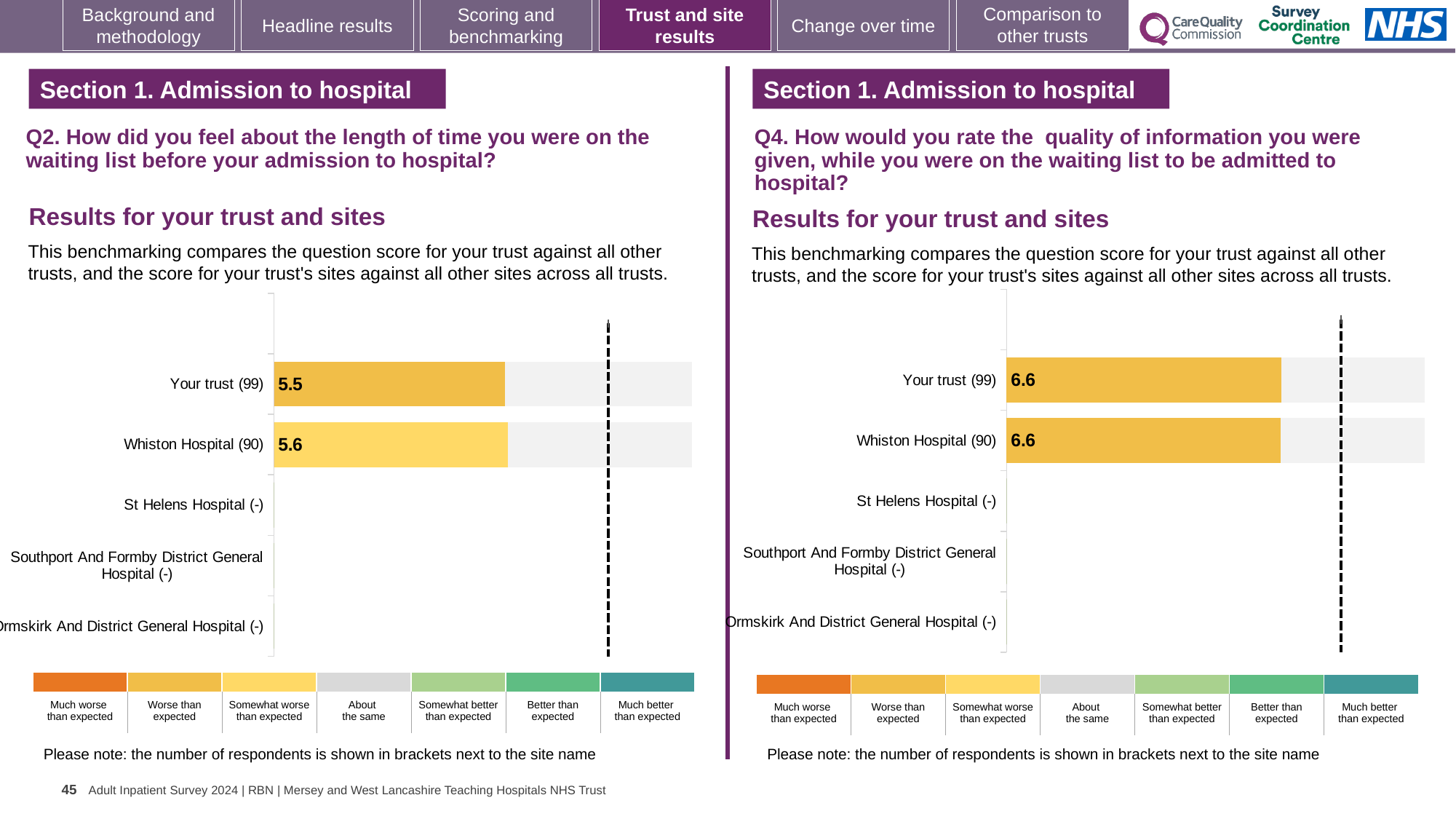
In the Q2 chart on the left, how many categories have a plotted bar? 2 In the Q4 chart on the right, how many respondents are shown in brackets for Your trust? 99 In the Q4 chart on the right, is the Your trust score greater or less than the Whiston Hospital score, or are they equal? Equal In the Q4 chart on the right, what is the score for Your trust? 6.6 In the Q2 chart on the left, how many respondents are shown in brackets for Whiston Hospital? 90 In the Q2 chart on the left, what is the difference between the Whiston Hospital score and the Your trust score? 0.1 How many site or trust categories are listed on the y axis of the Q2 chart on the left? 5 What type of chart is used on the left-hand side of the slide for Q2? Bar chart In the Q4 chart on the right, what is the score for Whiston Hospital? 6.6 In the Q2 chart on the left, what is the score for Your trust? 5.5 In the Q4 chart on the right, what is the difference between the Your trust score and the Whiston Hospital score? 0 In the Q2 chart on the left, what is the score for Whiston Hospital? 5.6